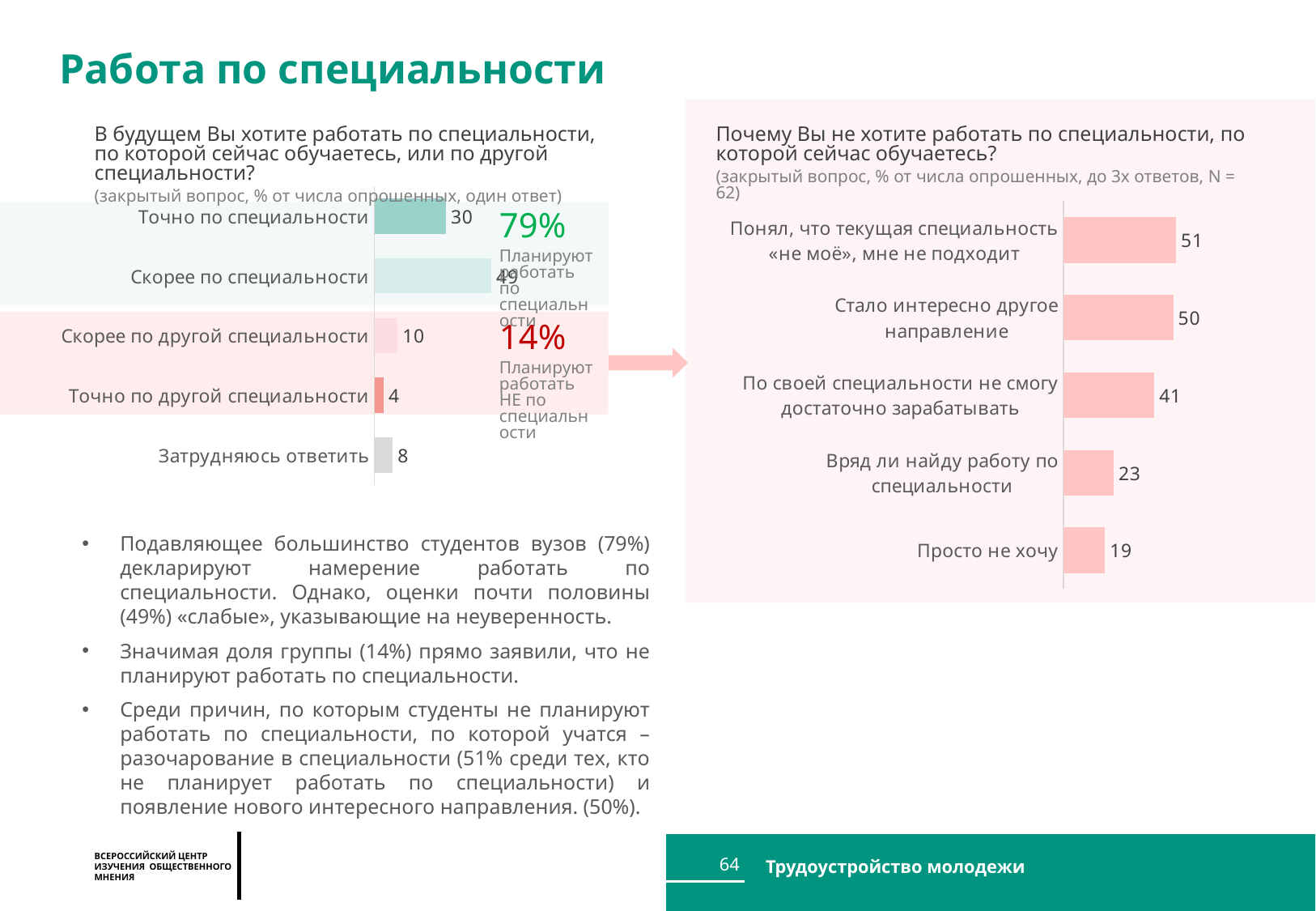
In the left chart, what is the value for «Скорее по другой специальности»? 10 In the left chart, which category has the lowest value? Точно по другой специальности How many categories does the left chart show? 5 In the left chart, what is the value for «Точно по специальности»? 30 In the right chart, which is larger: «Вряд ли найду работу по специальности» or «Просто не хочу»? Вряд ли найду работу по специальности What type of chart is the right chart? Bar chart In the left chart, which category has the highest value? Скорее по специальности In the right chart, what is the value for «Просто не хочу»? 19 In the right chart, which category has the highest value? Понял, что текущая специальность «не моё», мне не подходит In the right chart, what is the difference between «Стало интересно другое направление» and «Вряд ли найду работу по специальности»? 27 In the right chart, what is the value for «По своей специальности не смогу достаточно зарабатывать»? 41 In the left chart, what is the difference between «Скорее по специальности» and «Точно по специальности»? 19